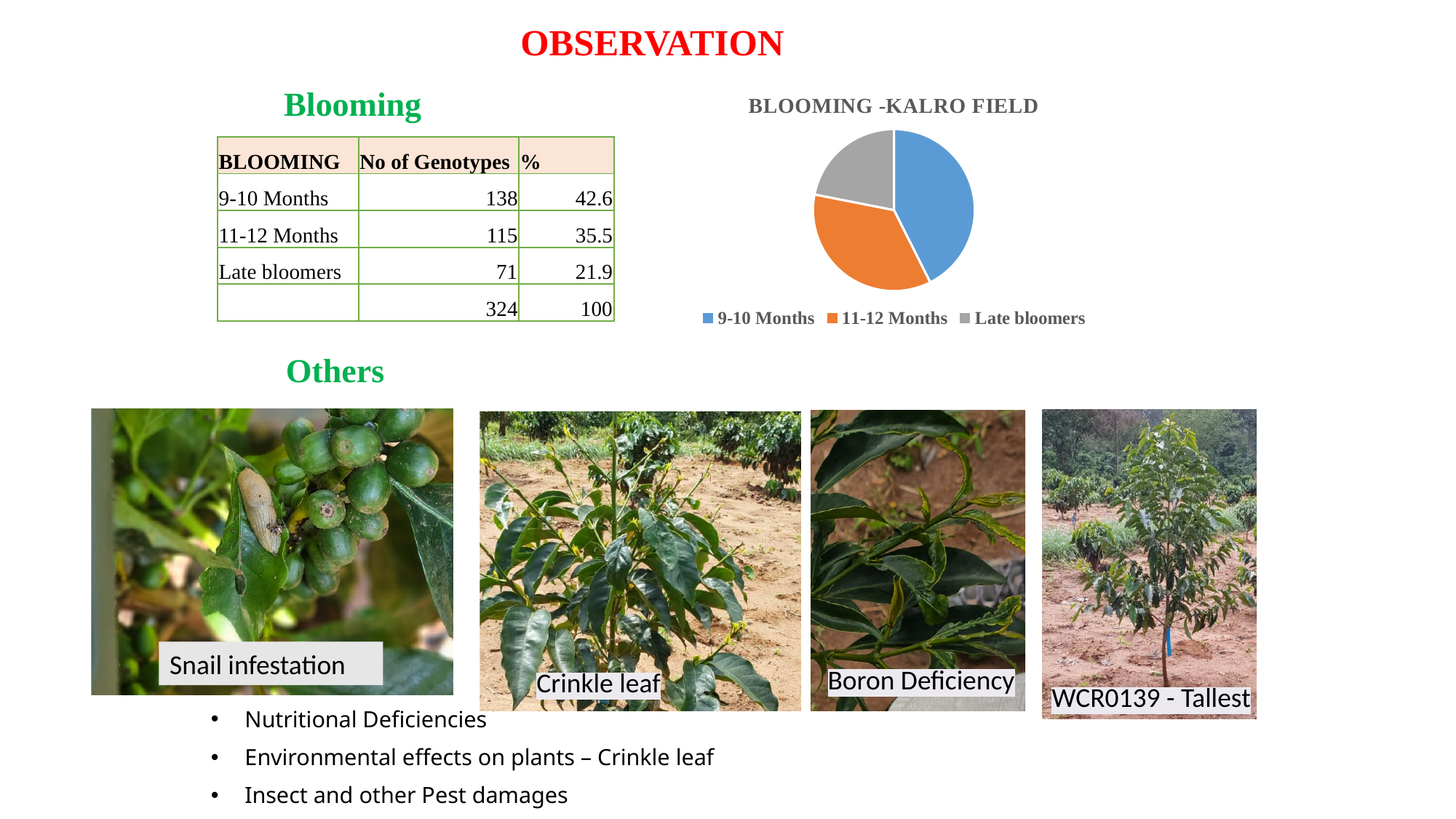
According to the Blooming table on the slide, how many genotypes are in the 11-12 Months category? 115 According to the Blooming table on the slide, what percentage share does the Late bloomers category have? 21.9 How many slices does the BLOOMING -KALRO FIELD pie chart have? 3 Which category has the smallest slice in the BLOOMING -KALRO FIELD pie chart? Late bloomers According to the Blooming table on the slide, what percentage share does the 9-10 Months category have? 42.6 What colour is the 9-10 Months slice in the BLOOMING -KALRO FIELD pie chart? blue Which category has the largest slice in the BLOOMING -KALRO FIELD pie chart? 9-10 Months According to the Blooming table on the slide, what is the total number of genotypes across all blooming categories? 324 What kind of chart is shown under the title BLOOMING -KALRO FIELD? pie chart What is the title of the pie chart on the slide? BLOOMING -KALRO FIELD How many entries does the legend of the BLOOMING -KALRO FIELD pie chart list? 3 In the BLOOMING -KALRO FIELD pie chart, which slice is larger: 11-12 Months or Late bloomers? 11-12 Months